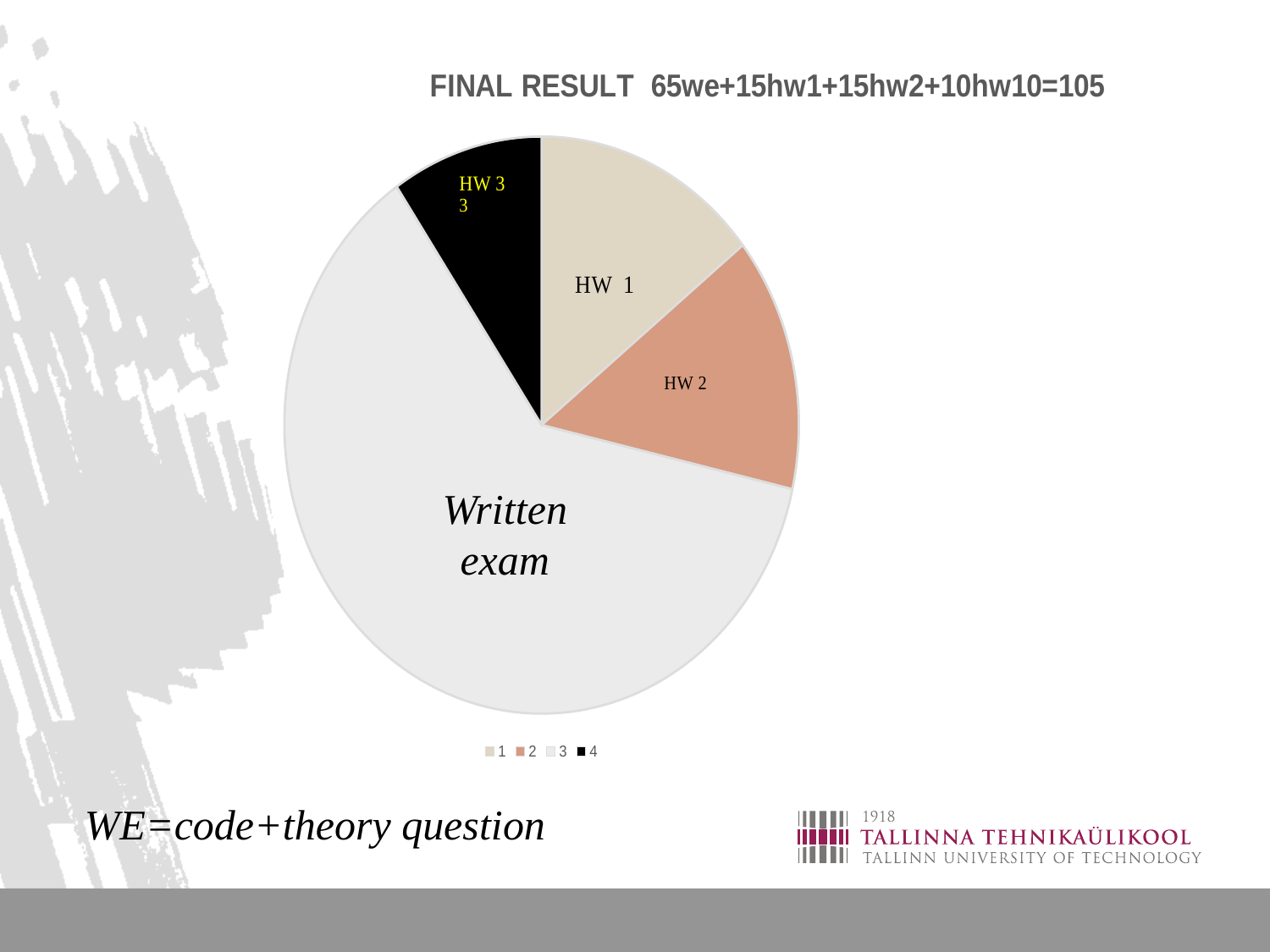
How many entries does the legend of the pie chart list? 4 How many slices does the pie chart have? 4 What colour is the HW 3 slice of the pie chart? black Which slice is larger in the pie chart, HW 2 or HW 3? HW 2 Which slice is larger in the pie chart, Written exam or HW 2? Written exam Which slice of the pie chart is the largest? Written exam Which slice of the pie chart is the smallest? HW 3 What kind of chart is shown on the slide? pie chart What is the title shown above the pie chart? FINAL RESULT 65we+15hw1+15hw2+10hw10=105 Which slice is larger in the pie chart, HW 1 or HW 3? HW 1